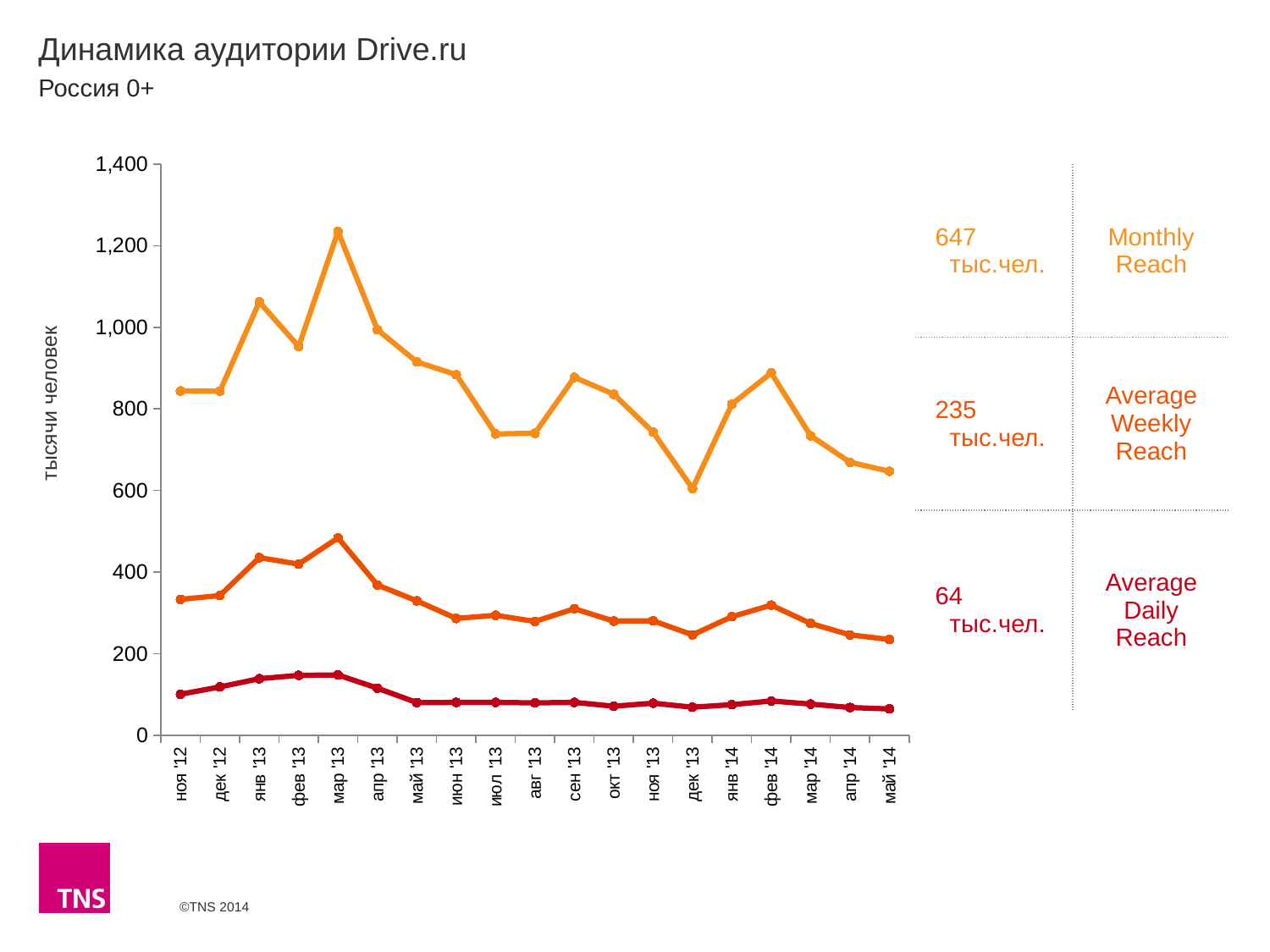
Which is larger, the Monthly Reach value for янв '13 or for фев '13? янв '13 How many time points are plotted along the x axis? 19 What is the difference between the printed Monthly Reach and Average Weekly Reach values? 412 тыс.чел. Is the Monthly Reach value for мар '13 greater or less than 1,000? greater What Monthly Reach value is printed on the slide? 647 тыс.чел. What is the label on the y axis? тысячи человек How many lines (series) are plotted on the chart? 3 In which month does the Monthly Reach line reach its lowest point? дек '13 What Average Weekly Reach value is printed on the slide? 235 тыс.чел. What type of chart is shown on the slide? line chart In which month does the Monthly Reach line reach its highest point? мар '13 What Average Daily Reach value is printed on the slide? 64 тыс.чел.